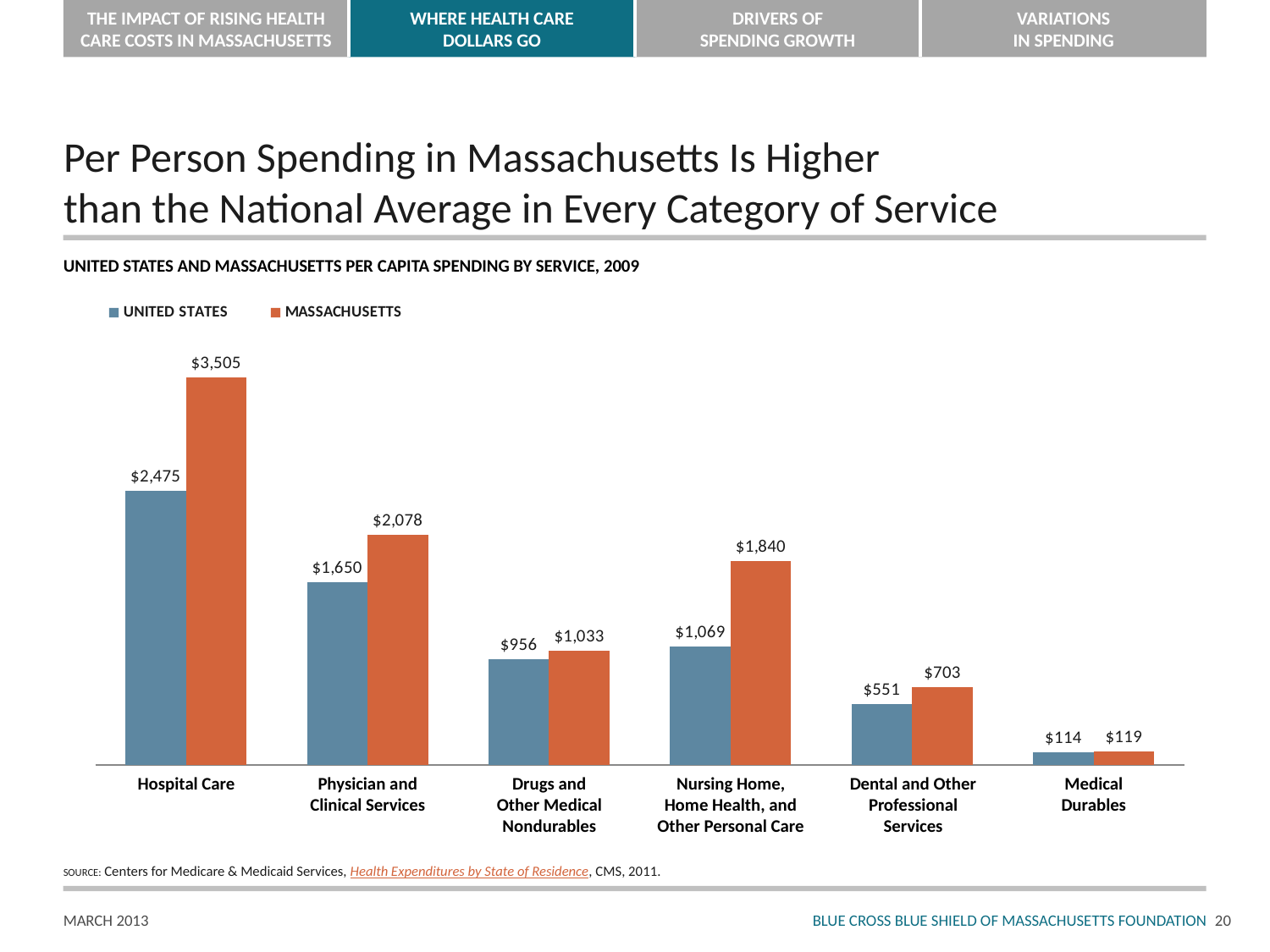
Which is larger for Drugs and Other Medical Nondurables: the United States value or the Massachusetts value? Massachusetts Which category has the lowest United States per capita spending? Medical Durables What is the difference between the Massachusetts and United States values for Hospital Care? $1,030 How many series does the legend list? 2 What is the United States value for Medical Durables? $114 What is the United States per capita spending for Physician and Clinical Services? $1,650 What kind of chart is shown on the slide? Bar chart How many service categories are shown on the x axis? 6 What is the Massachusetts per capita spending for Hospital Care? $3,505 Which category has the highest Massachusetts per capita spending? Hospital Care What is the Massachusetts value for Nursing Home, Home Health, and Other Personal Care? $1,840 What is the difference between the Massachusetts and United States values for Dental and Other Professional Services? $152